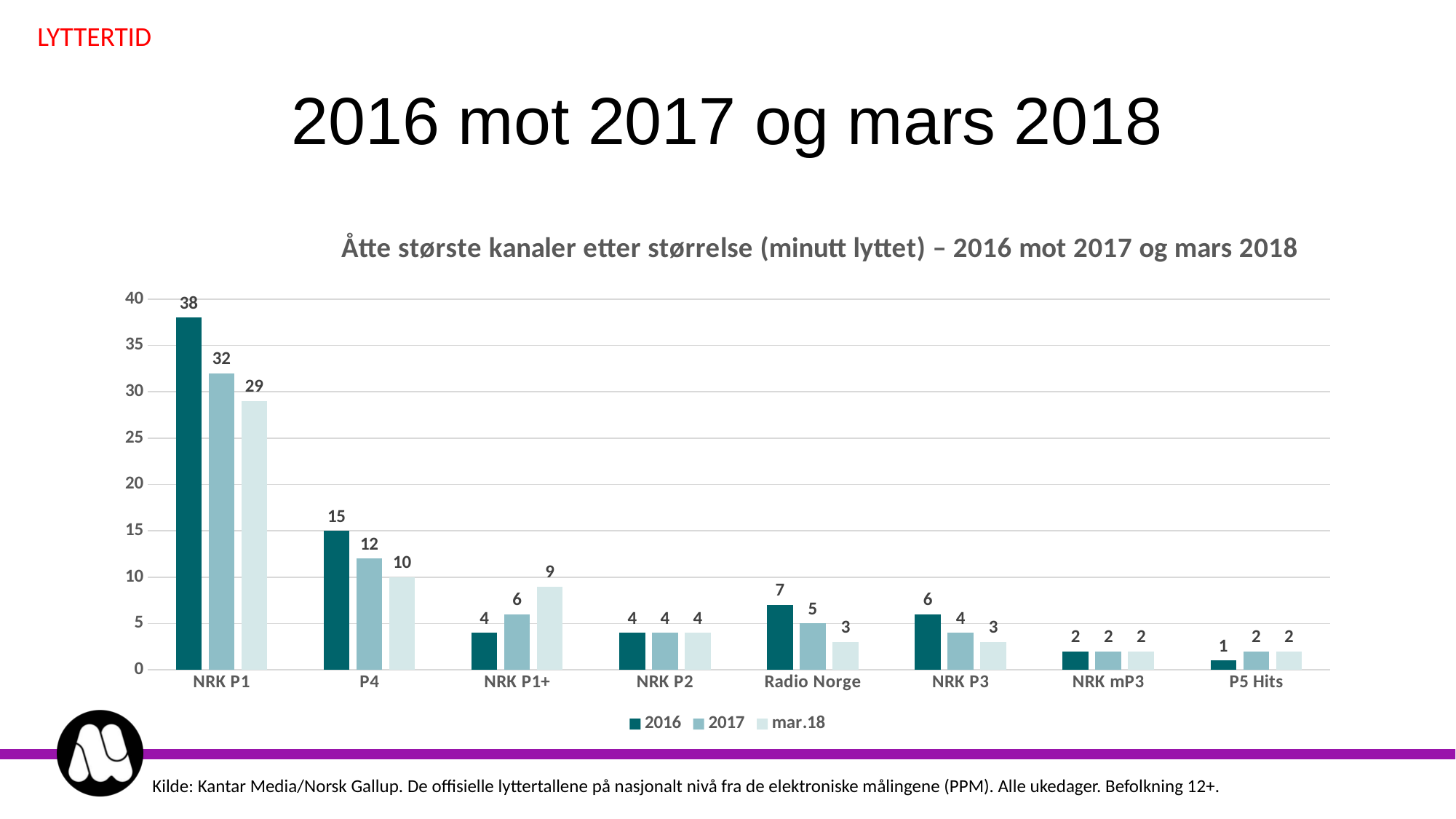
Do the 2016 values rise or fall from NRK P1 to P4? fall What is the 2016 value for NRK P1? 38 What is the difference between the 2016 and mar.18 values for NRK P1? 9 What is the 2017 value for Radio Norge? 5 What is the mar.18 value for P4? 10 What is the title of the chart? Åtte største kanaler etter størrelse (minutt lyttet) – 2016 mot 2017 og mars 2018 Which channel has the highest 2016 value? NRK P1 What kind of chart is shown? bar chart Which is larger for NRK P1+: the 2016 value or the mar.18 value? mar.18 Which channel has the lowest 2016 value? P5 Hits How many channels are shown on the x axis? 8 How many series does the legend list? 3